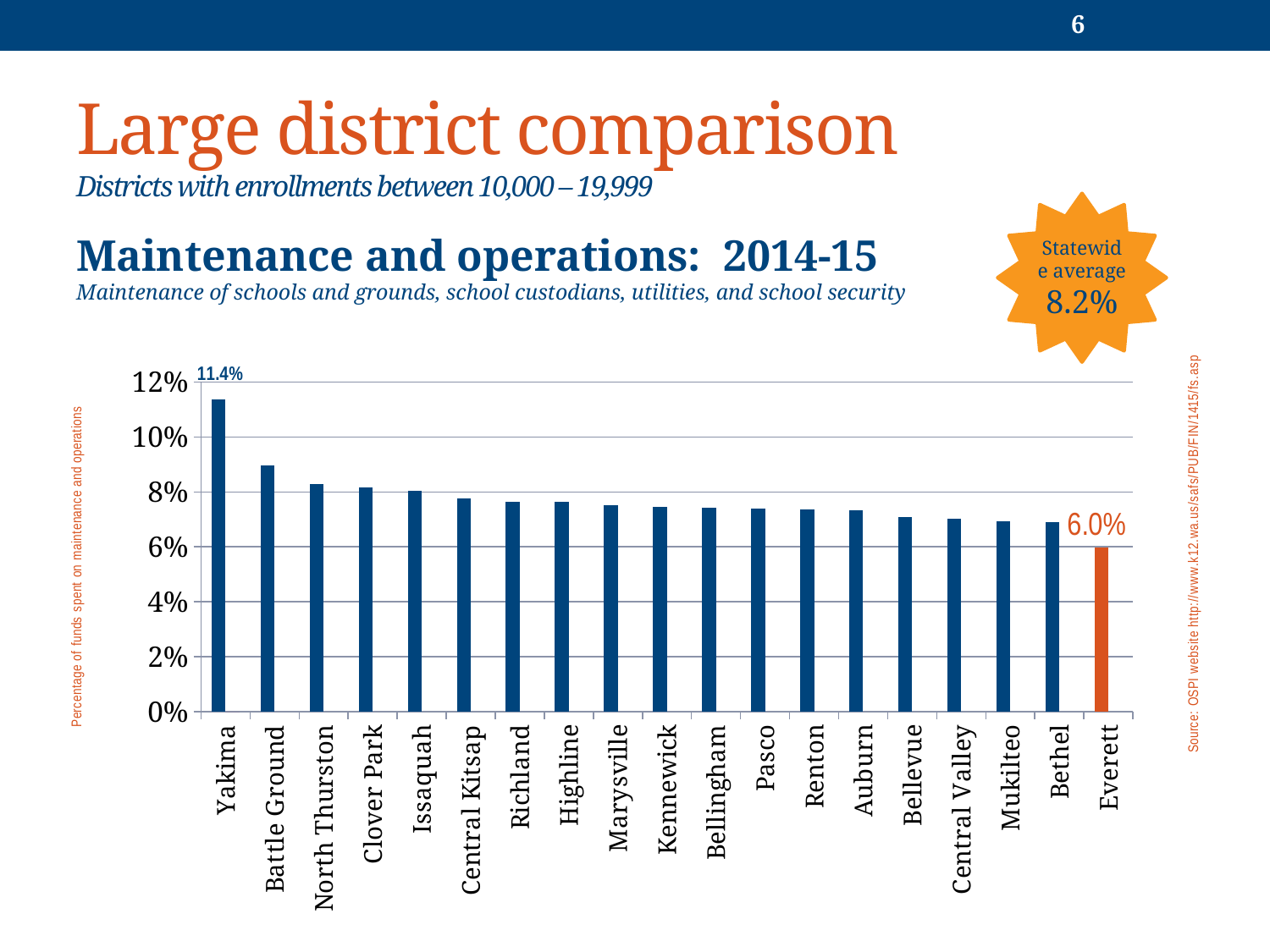
Is the value for Battle Ground greater or less than 8%? greater What is the value for Everett? 6.0% What is the difference between the values for Yakima and Everett? 5.4 percentage points How many districts are shown on the chart? 19 Do the values rise or fall moving from left to right along the x axis? Fall Is the value for Bellevue greater or less than 8%? less What is the value for Yakima? 11.4% Which is larger, the value for Battle Ground or the value for Bethel? Battle Ground Which district has the lowest percentage of funds spent on maintenance and operations? Everett What kind of chart is shown on the slide? Bar chart Which district has the highest percentage of funds spent on maintenance and operations? Yakima What statewide average is shown in the starburst on the slide? 8.2%